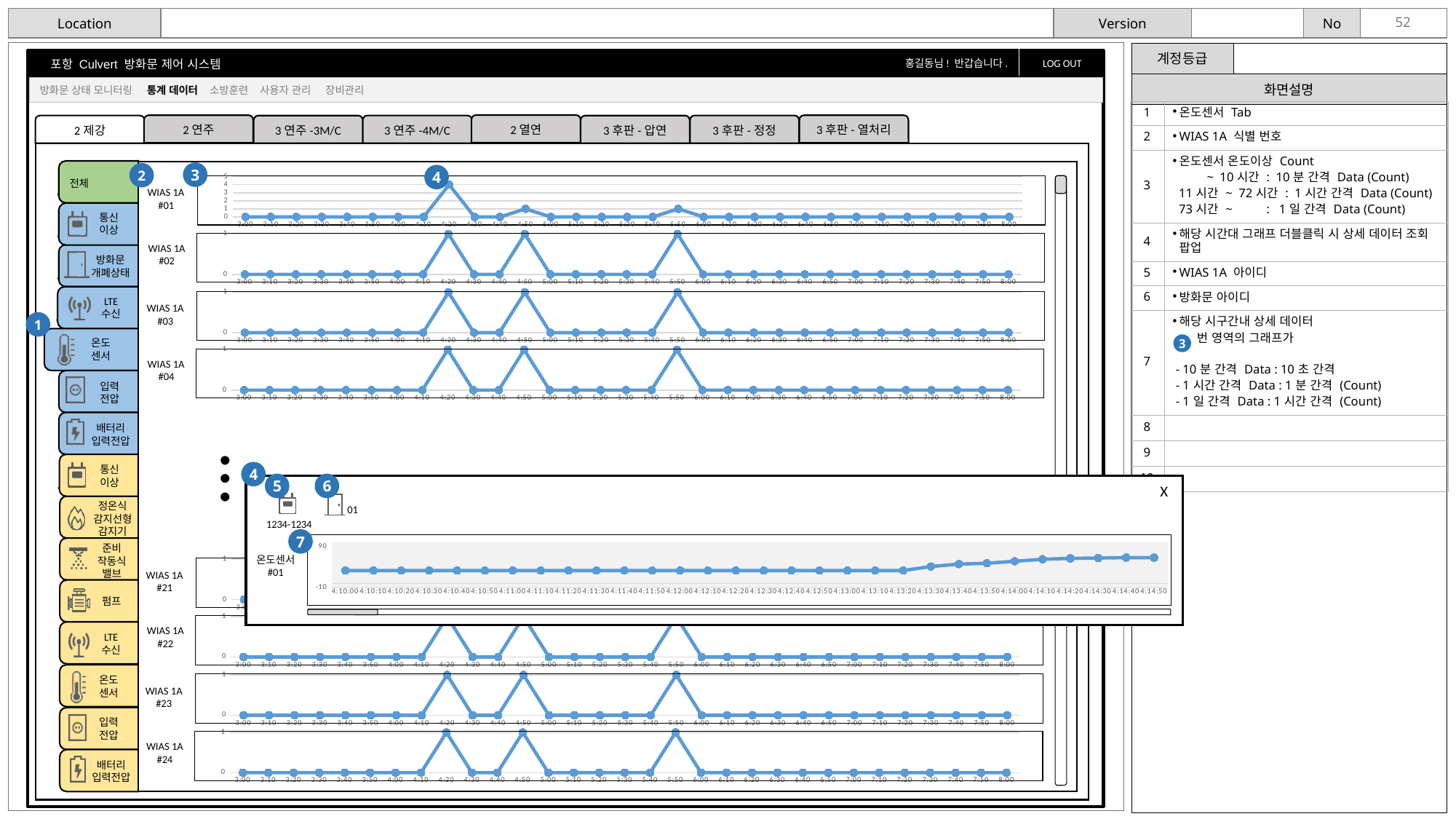
In the WIAS 1A #23 chart, how many times does the line rise to 1? 3 What kind of chart is used for the WIAS 1A #02 panel? line chart In the WIAS 1A #04 chart, which is larger, the value at 4:20 or the value at 4:30? 4:20 What is the last time label on the x axis of the WIAS 1A #22 chart? 8:00 In the WIAS 1A #02 chart, what is the value at 4:20? 1 In the WIAS 1A #03 chart, what is the value at 3:00? 0 In the popup chart labelled 온도센서 #01, do the values rise or fall toward the right end of the x axis? rise In the popup chart labelled 온도센서 #01, is the value at 4:10:00 greater or less than 90? less In the WIAS 1A #24 chart, at which times does the line reach 1? 4:20, 4:50, 5:50 What is the highest y-axis tick shown on the WIAS 1A #01 chart? 5 In the WIAS 1A #22 chart, what is the value at 6:00? 0 What is the first time label on the x axis of the WIAS 1A #02 chart? 3:00